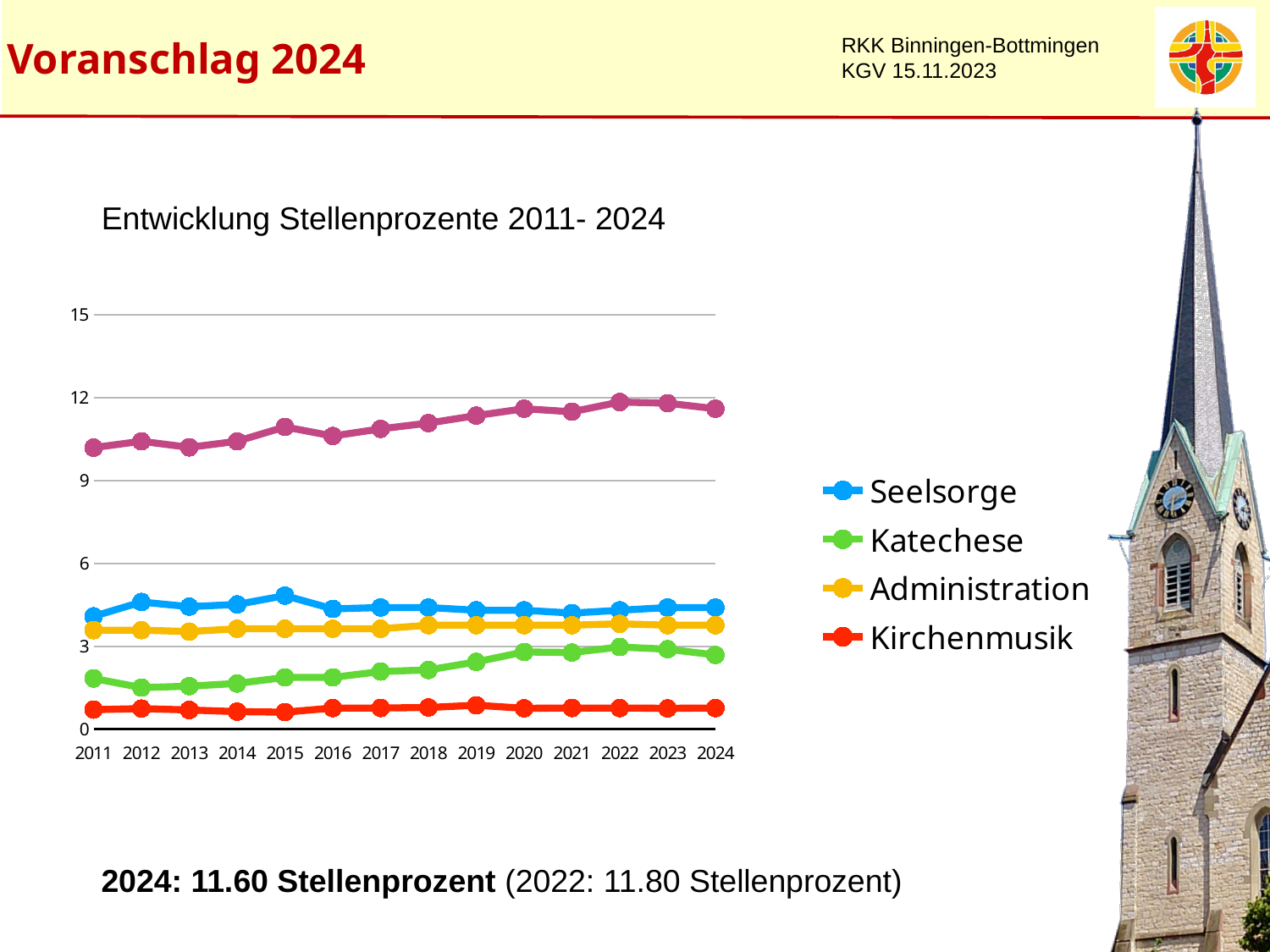
Which series in the legend has the highest values across all years? Seelsorge Which series in the legend has the lowest values across all years? Kirchenmusik Is the value for Katechese in 2011 greater or less than 3? less What is the title of the chart? Entwicklung Stellenprozente 2011- 2024 What colour is the Seelsorge line in the chart? blue Does the Katechese line rise or fall from 2011 to 2024? rise How many years are shown on the x axis of the chart? 14 What kind of chart is shown on the slide? line chart In 2011, which is larger: the value for Seelsorge or the value for Katechese? Seelsorge How many series does the chart legend list? 4 Is the value for Seelsorge in 2015 greater or less than 3? greater Is the value for Kirchenmusik in 2024 greater or less than 3? less